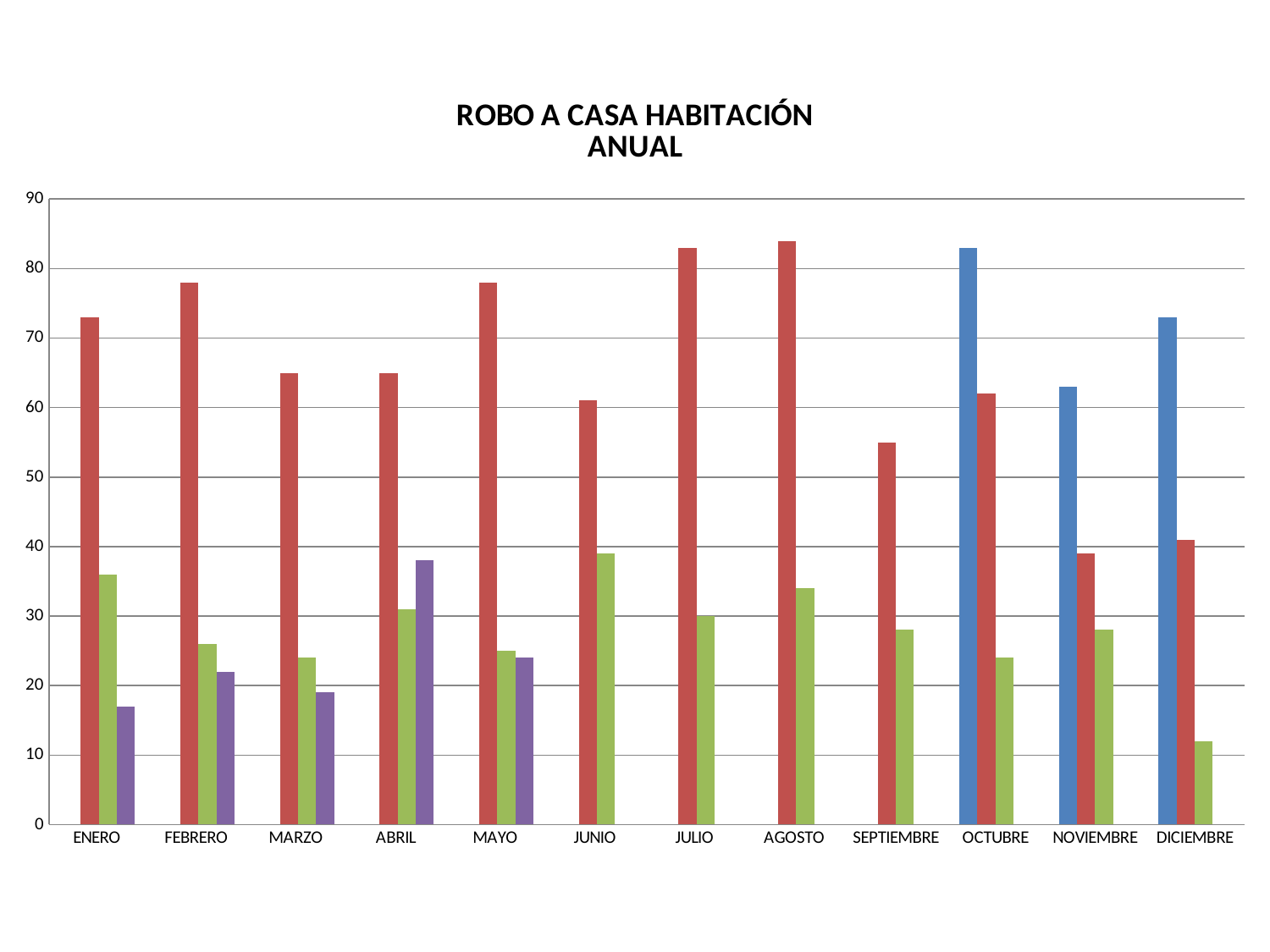
Which is larger, the blue bar for OCTUBRE or the blue bar for NOVIEMBRE? OCTUBRE Which month has the lowest red bar? NOVIEMBRE Which month has the tallest purple bar? ABRIL Is the green bar for DICIEMBRE greater or less than 20? less Is the purple bar for ABRIL greater or less than 30? greater What is the title of the chart? ROBO A CASA HABITACIÓN ANUAL Is the red bar for AGOSTO greater or less than 80? greater What kind of chart is shown on the slide? bar chart How many months are shown along the x axis? 12 Which is larger, the red bar for FEBRERO or the red bar for MARZO? FEBRERO Which months have a blue bar? OCTUBRE, NOVIEMBRE, DICIEMBRE